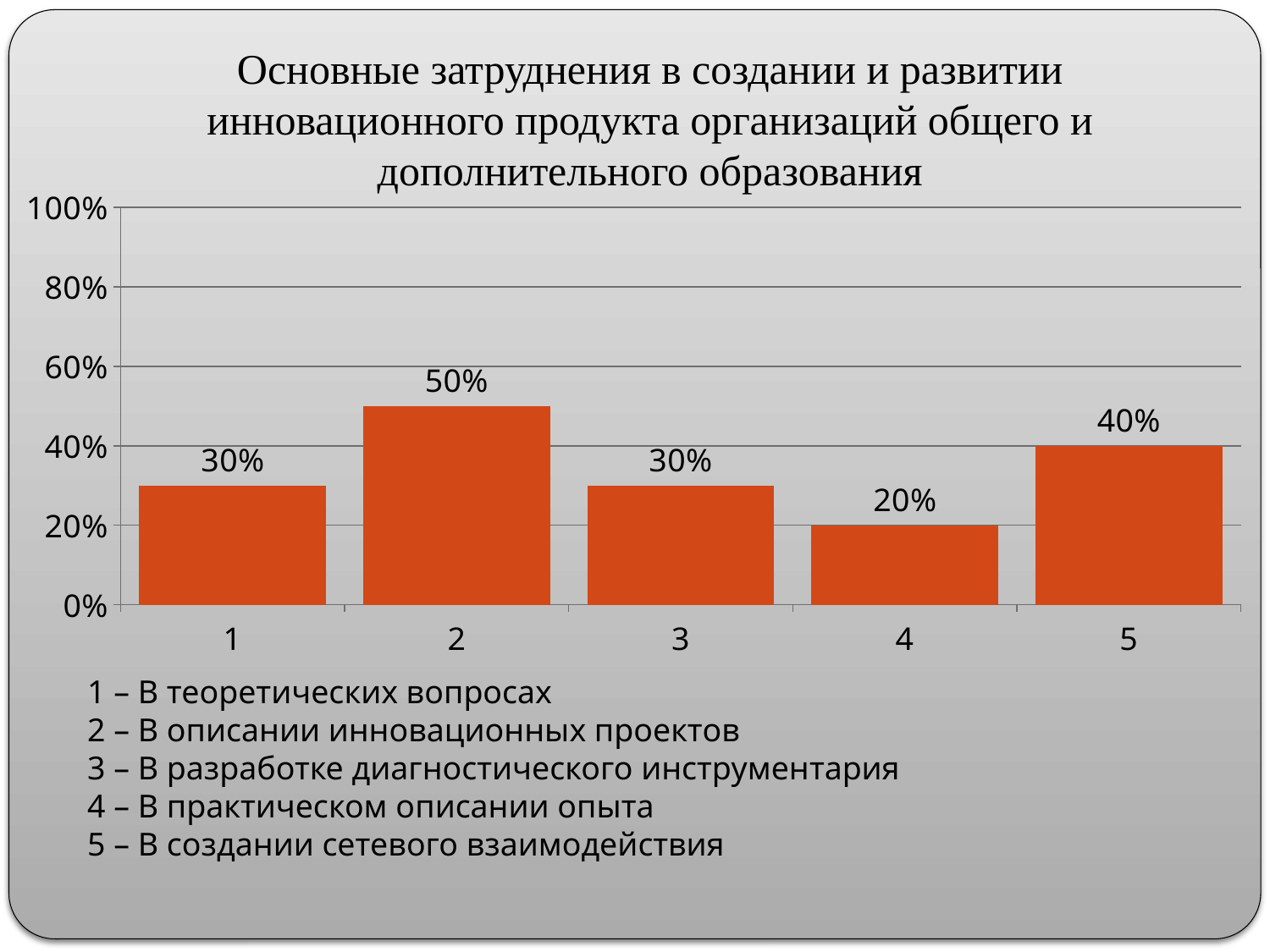
What is the value for category 5 (В создании сетевого взаимодействия)? 40% Is the value for category 2 greater or less than 40%? greater How many categories are shown in the chart? 5 Which category has the lowest value? 4 Which category has the highest value? 2 What is the value for category 2 (В описании инновационных проектов)? 50% What kind of chart is shown on the slide? bar chart What colour are the bars in the chart? orange-red Which is larger, the value for category 5 or the value for category 3? category 5 What is the difference between the values for category 2 and category 4? 30% What is the value for category 4 (В практическом описании опыта)? 20% What is the difference between the values for category 5 and category 1? 10%